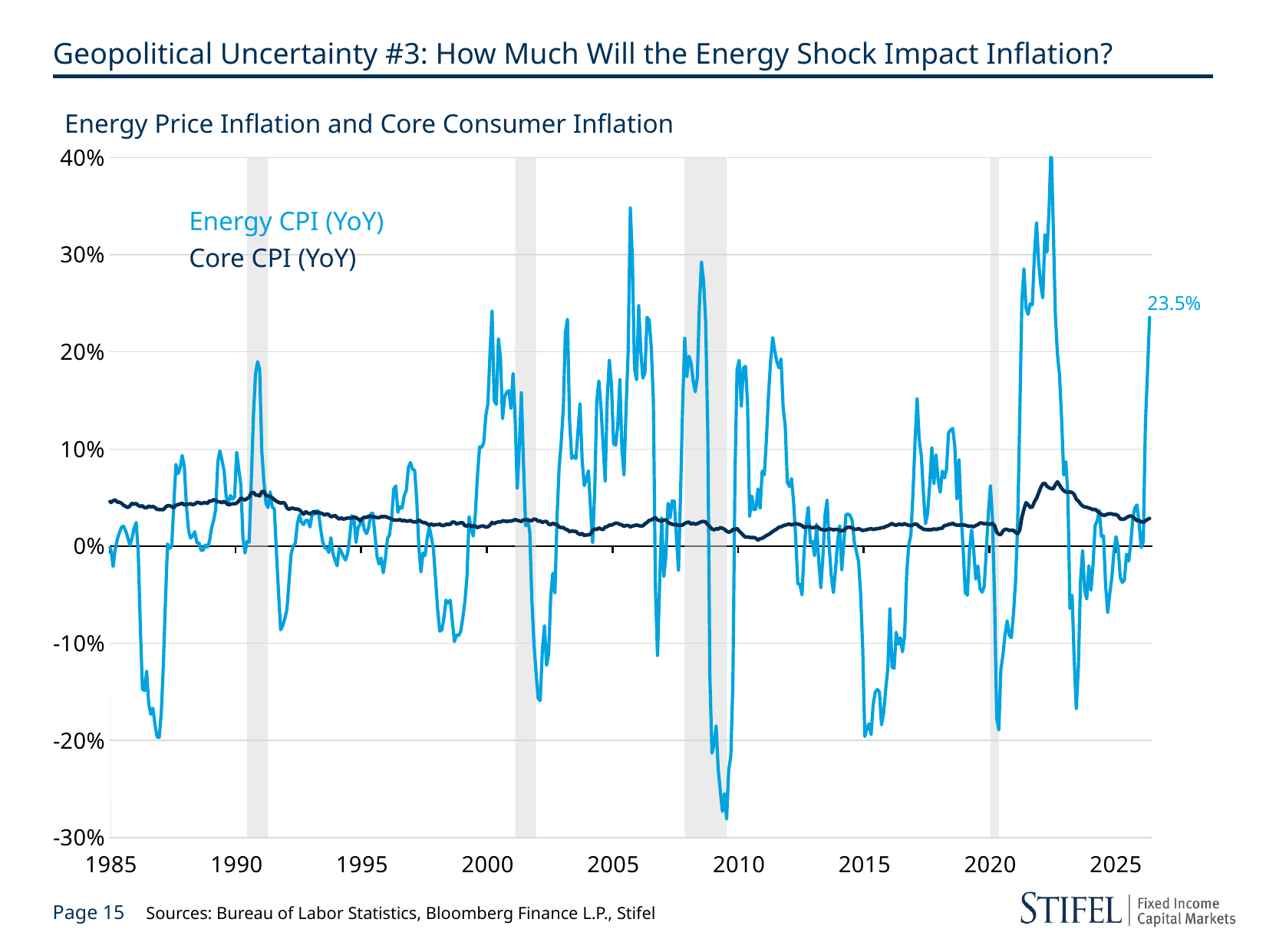
What colour is the Energy CPI (YoY) line? light blue What is the latest labelled value of Energy CPI (YoY) at the right end of the chart? 23.5% What is the title of the chart? Energy Price Inflation and Core Consumer Inflation Is the lowest point of Energy CPI (YoY) around 2009 greater or less than -20%? less Which series reaches the highest value anywhere on the chart? Energy CPI (YoY) How many series does the chart's legend list? 2 What kind of chart is shown on the slide? line chart Is the peak of Core CPI (YoY) around 2022 greater or less than 10%? less Is the latest labelled Energy CPI (YoY) value greater or less than 20%? greater At the right end of the chart, which series is higher, Energy CPI (YoY) or Core CPI (YoY)? Energy CPI (YoY)